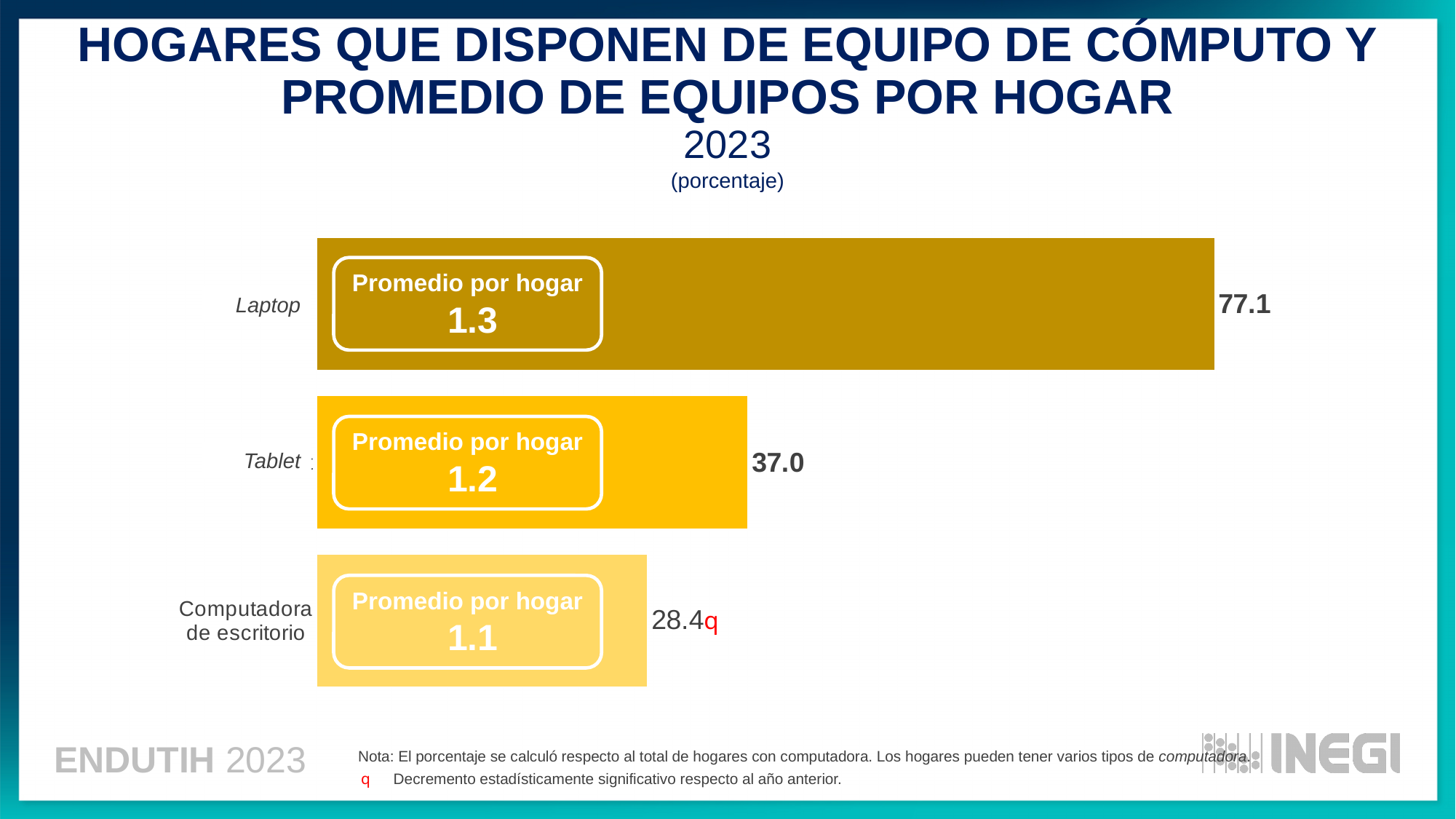
How many categories of computer equipment are shown in the chart? 3 What is the difference in percentage points between Laptop and Tablet? 40.1 Which is larger, the percentage for Tablet or for Computadora de escritorio? Tablet Which type of computer equipment has the lowest percentage of households? Computadora de escritorio What percentage of households have a desktop computer (Computadora de escritorio)? 28.4 What kind of chart is shown on the slide? Bar chart What is the average number of desktop computers per household shown in the Computadora de escritorio bar? 1.1 What is the average number of laptops per household shown in the Laptop bar? 1.3 Which type of computer equipment has the highest percentage of households? Laptop What percentage of households have a tablet? 37.0 What is the average number of tablets per household shown in the Tablet bar? 1.2 What percentage of households have a laptop? 77.1